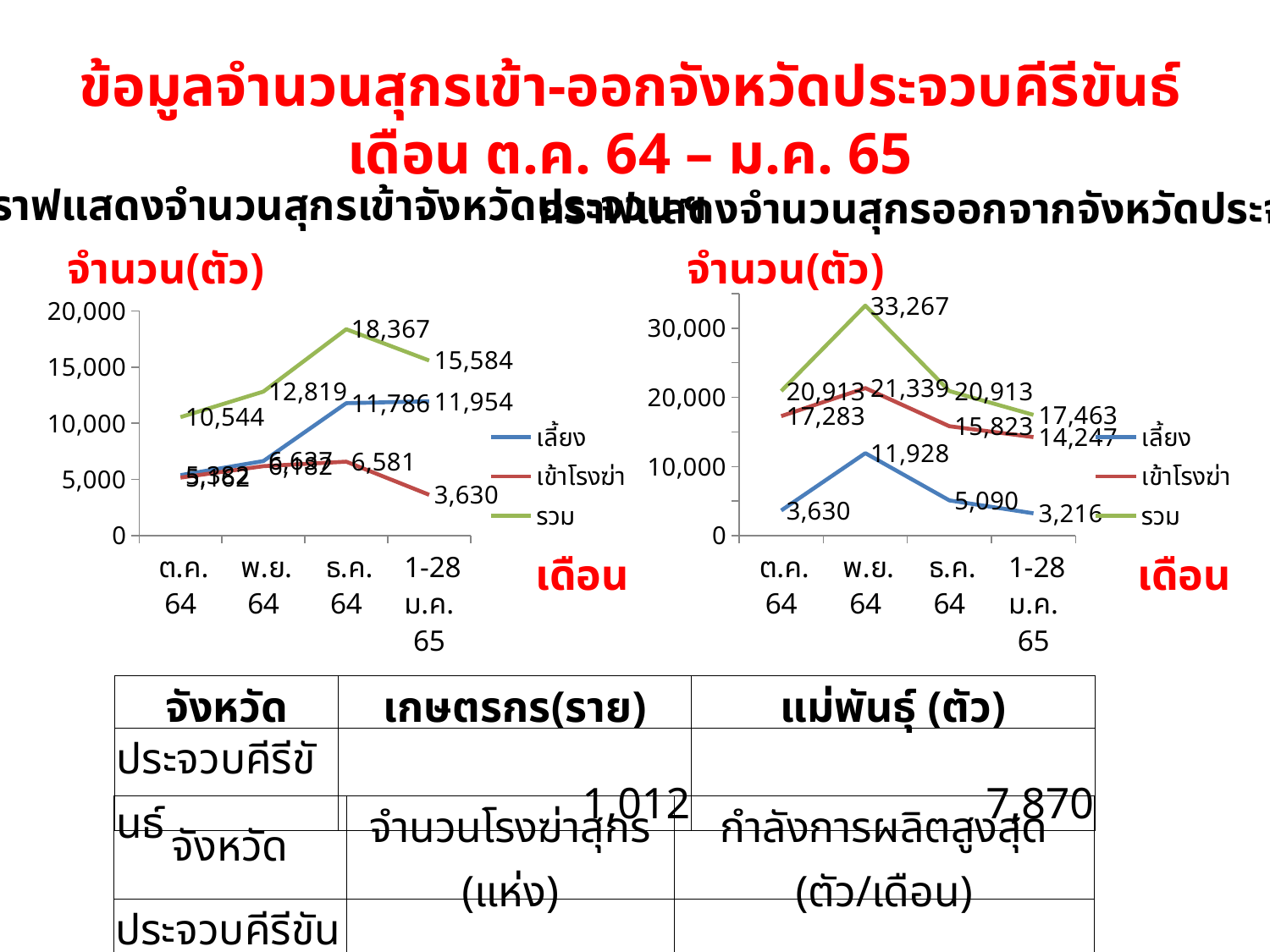
In the left chart, what is the value of เลี้ยง for 1-28 ม.ค. 65? 11,954 In the right chart, what is the value of รวม for พ.ย. 64? 33,267 In the left chart, what is the value of รวม for ธ.ค. 64? 18,367 In the left chart, in which month is the รวม series highest? ธ.ค. 64 How many series does the legend of the right chart list? 3 In the right chart, which is larger for ธ.ค. 64: เลี้ยง or เข้าโรงฆ่า? เข้าโรงฆ่า How many months are shown on the x axis of the right chart? 4 What type of chart is the left chart? Line chart In the left chart, how much higher is รวม in ธ.ค. 64 than in 1-28 ม.ค. 65? 2,783 In the right chart, what is the difference between เข้าโรงฆ่า in พ.ย. 64 and in ต.ค. 64? 4,056 In the left chart, what is the value of เข้าโรงฆ่า for 1-28 ม.ค. 65? 3,630 In the right chart, in which month is the เลี้ยง series lowest? 1-28 ม.ค. 65